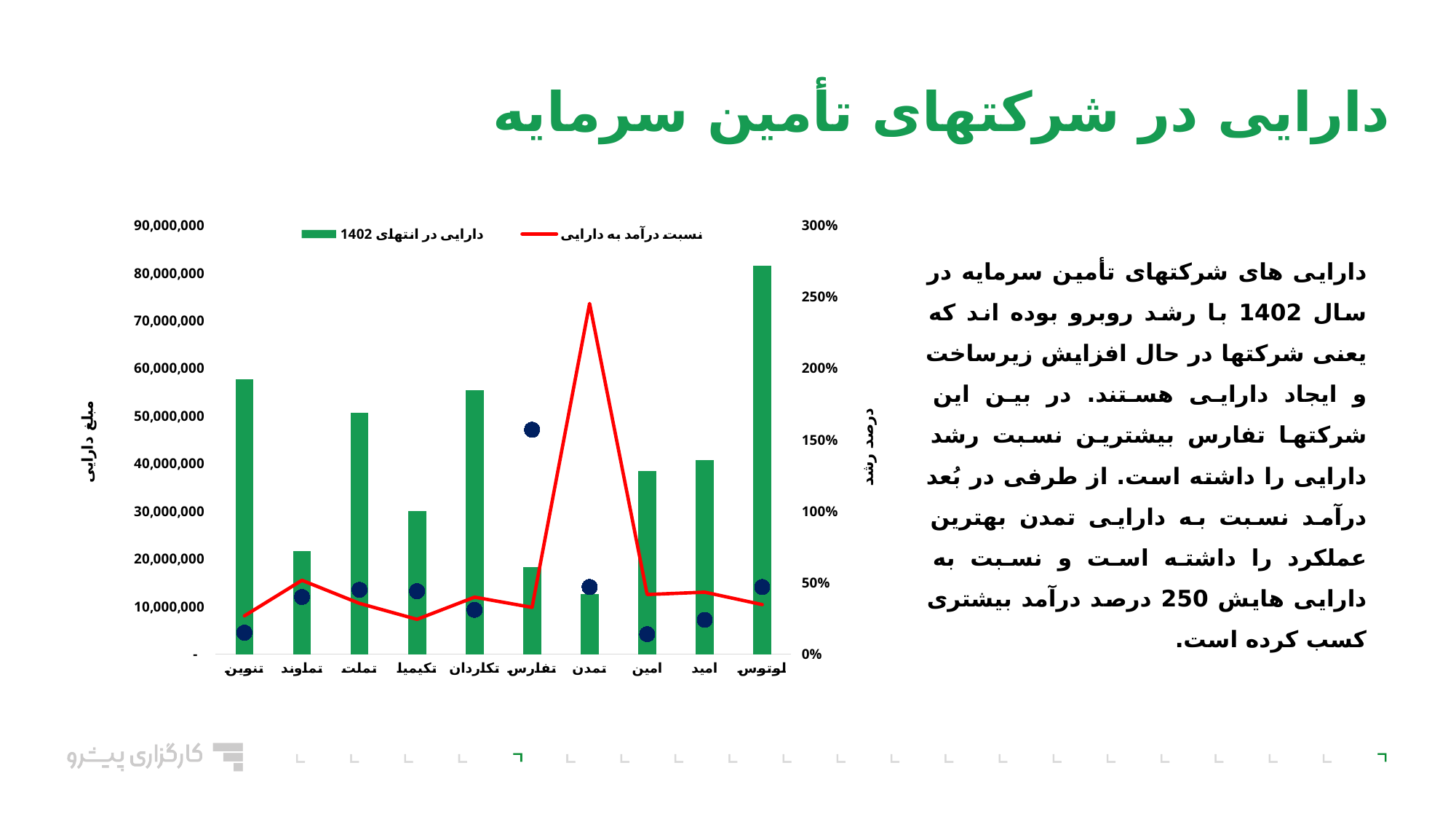
Which has the larger دارایی در انتهای 1402 bar, لوتوس or تنوین? لوتوس Is the نسبت درآمد به دارایی value for تمدن greater or less than 200%? greater Which company has the shortest bar for دارایی در انتهای 1402? تمدن How many companies are shown on the x axis of the chart? 10 Which company has the highest point on the red نسبت درآمد به دارایی line? تمدن Is the دارایی در انتهای 1402 bar for لوتوس greater or less than 70,000,000? greater Is the دارایی در انتهای 1402 bar for تنوین greater or less than 50,000,000? greater How many series does the chart legend list? 2 What colour are the bars for دارایی در انتهای 1402? Green Which has the larger دارایی در انتهای 1402 bar, تملت or تکیمیا? تملت Which company has the tallest bar for دارایی در انتهای 1402? لوتوس